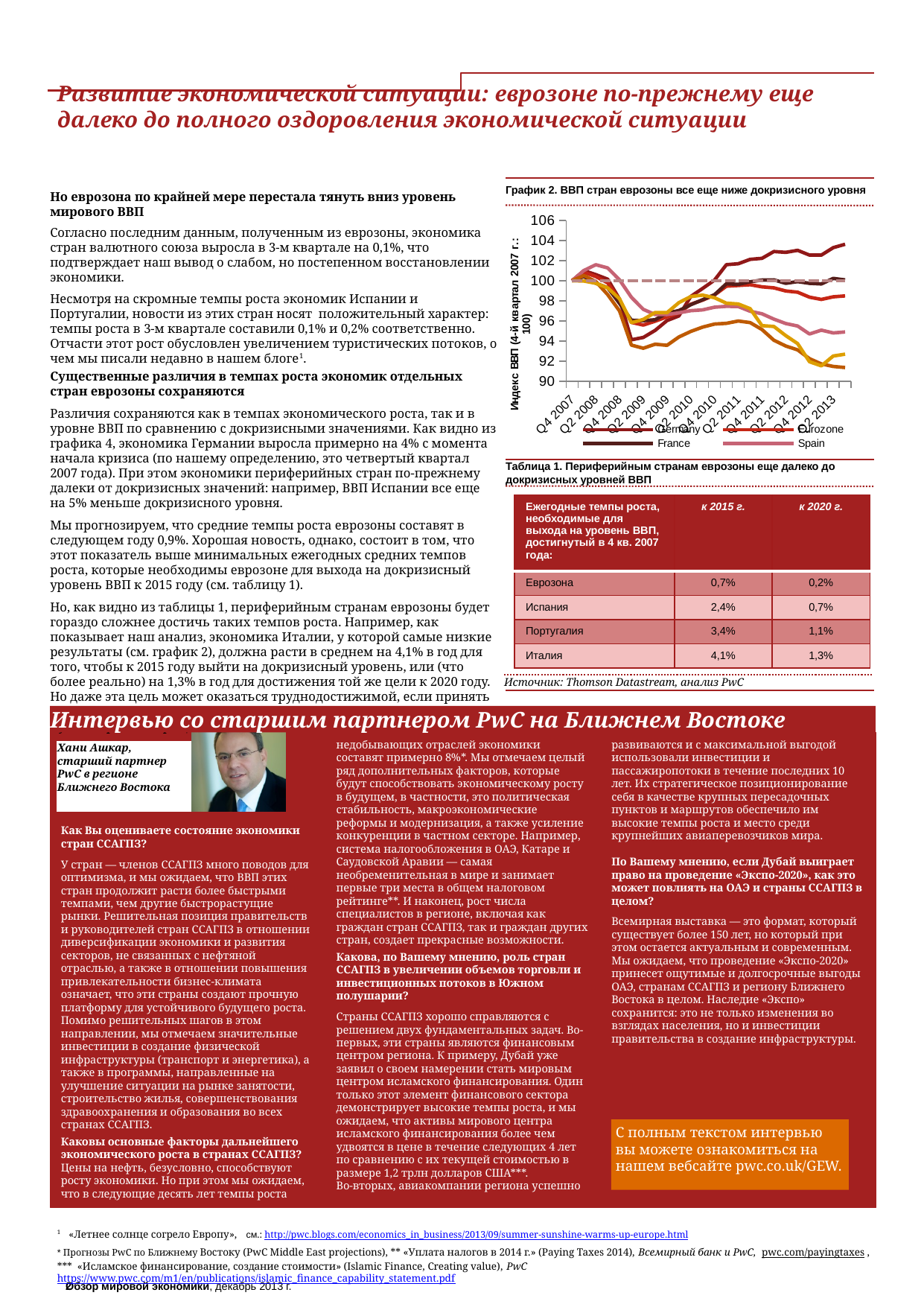
In the chart 'График 2', at Q2 2013, which is larger: the value for Germany or the value for Spain? Germany In the chart 'График 2', is the value for Spain at Q2 2013 greater or less than 98? less In the chart 'График 2', at Q2 2013, which is larger: the value for France or the value for Spain? France How many quarter labels are shown on the x axis of the chart 'График 2'? 12 In the chart 'График 2', which country's line is highest at Q2 2013? Germany What is the highest value shown on the y axis of the chart 'График 2'? 106 What kind of chart is 'График 2. ВВП стран еврозоны все еще ниже докризисного уровня'? line chart In the chart 'График 2', does the Germany line rise or fall between Q4 2010 and Q2 2013? rise What is the y-axis label of the chart 'График 2'? Индекс ВВП (4-й квартал 2007 г.: 100) In the chart 'График 2', is the value for Germany at Q2 2013 greater or less than 102? greater In the chart 'График 2', does the Spain line rise or fall between Q4 2007 and Q2 2013? fall